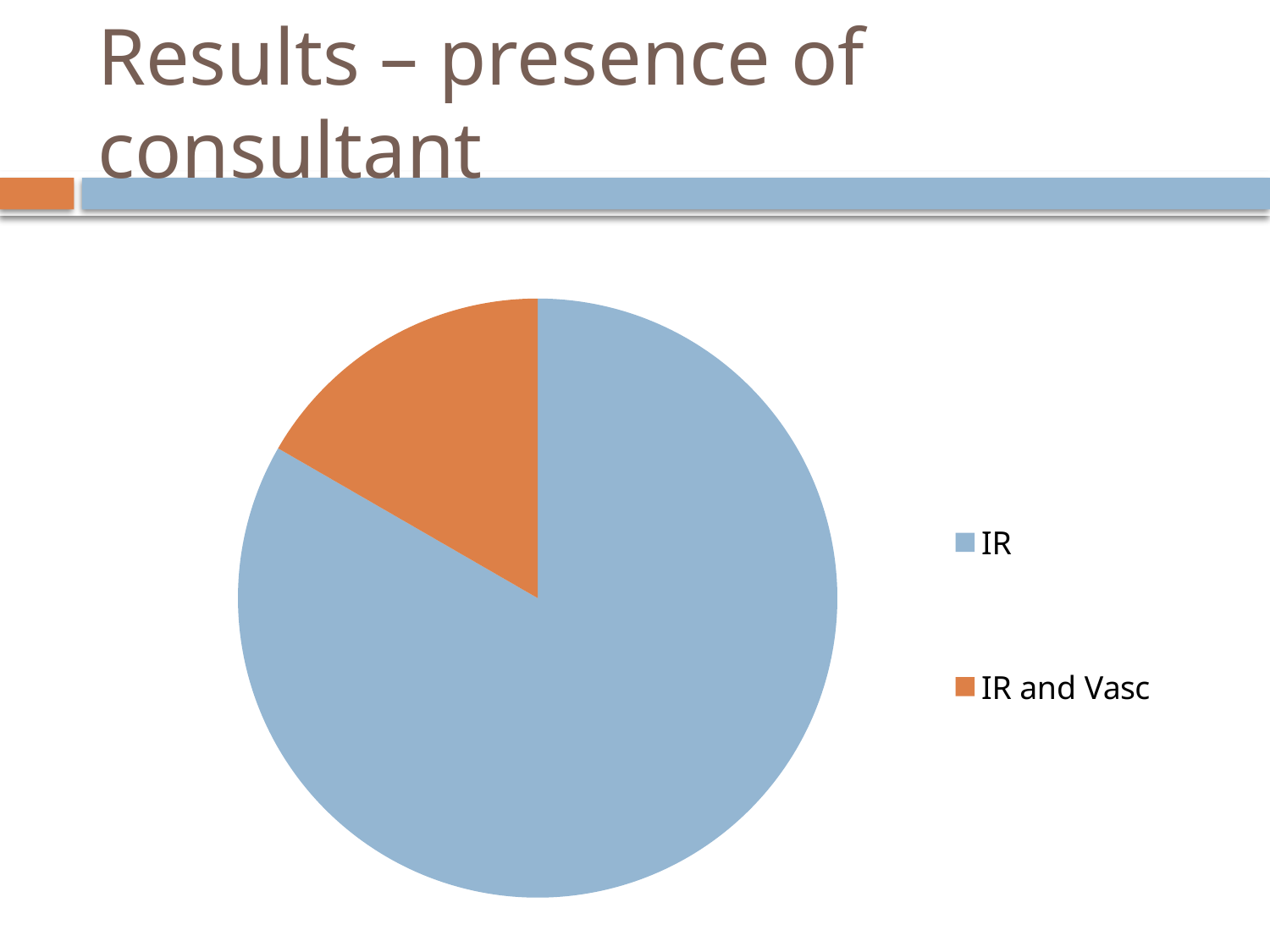
What colour is the slice for IR and Vasc? orange How many entries does the legend list? 2 Which category has the smallest slice of the pie? IR and Vasc What is the title of the slide containing the chart? Results – presence of consultant How many slices does the pie chart have? 2 Which slice is larger, IR or IR and Vasc? IR What kind of chart is shown on the slide? pie chart Which category has the largest slice of the pie? IR